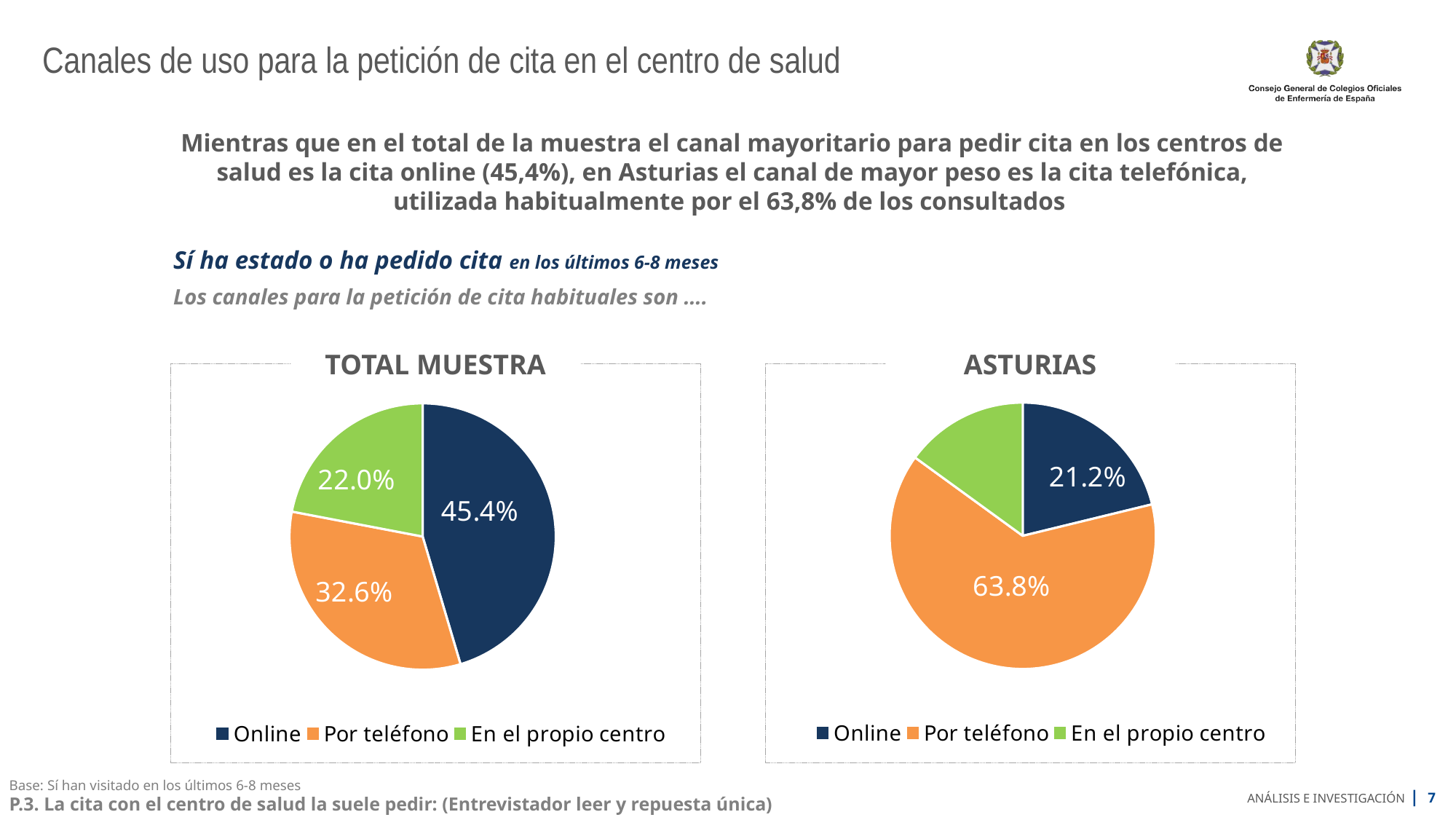
What kind of chart is used for ASTURIAS? Pie chart In the ASTURIAS pie chart, which category has the smallest share? En el propio centro In the TOTAL MUESTRA pie chart, what is the value for En el propio centro? 22.0% In the TOTAL MUESTRA pie chart, what is the difference in percentage points between Online and Por teléfono? 12.8 In the TOTAL MUESTRA pie chart, what is the value for Por teléfono? 32.6% In the ASTURIAS pie chart, what is the value for Online? 21.2% In the ASTURIAS pie chart, what is the value for Por teléfono? 63.8% In the ASTURIAS pie chart, which category has the largest share? Por teléfono In the TOTAL MUESTRA pie chart, which category has the largest share? Online In the TOTAL MUESTRA pie chart, what is the value for Online? 45.4% In the ASTURIAS pie chart, which is larger, Por teléfono or Online? Por teléfono How many categories does the legend of the TOTAL MUESTRA pie chart list? 3